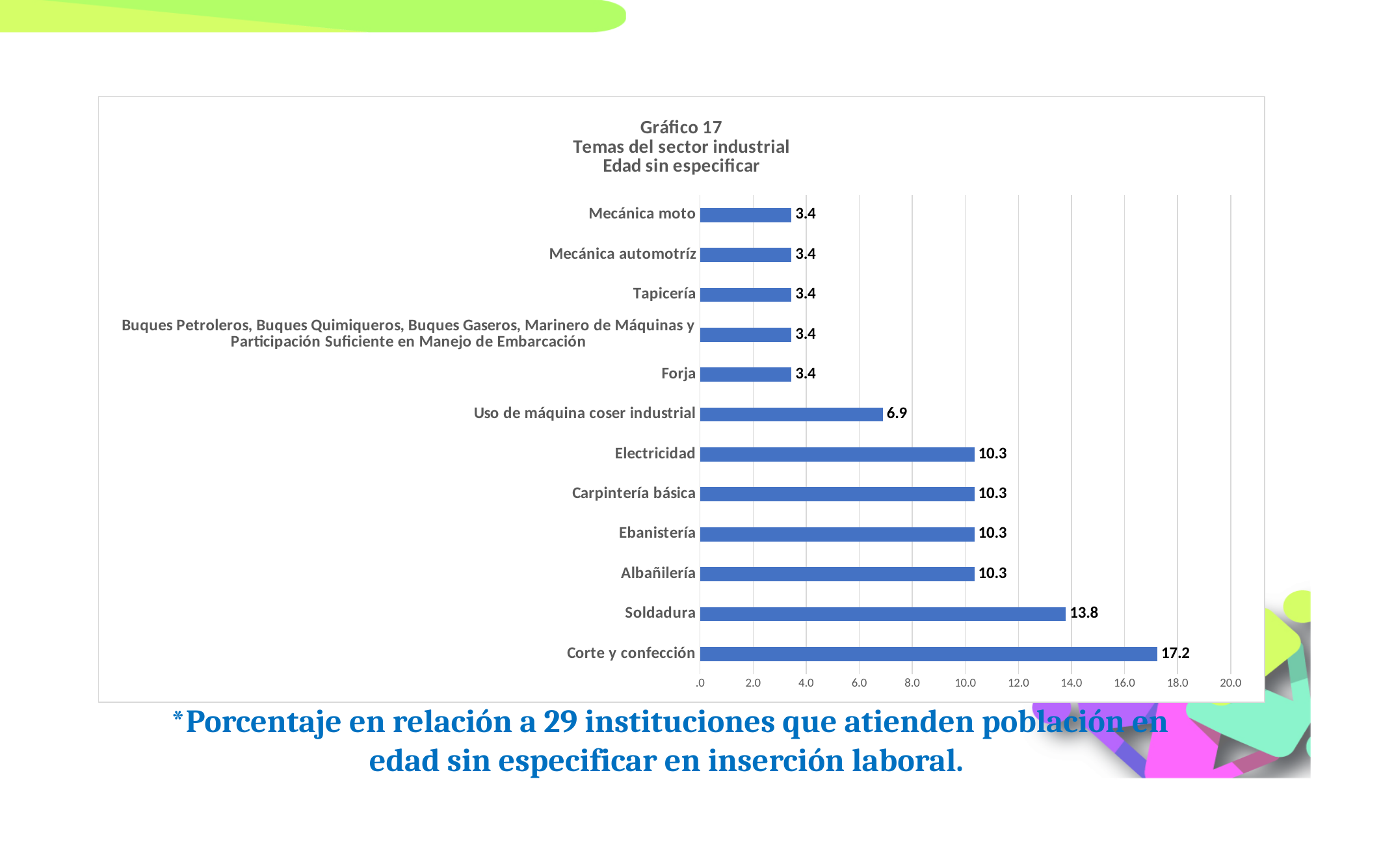
What kind of chart is shown on the slide? Bar chart What is the value for Forja? 3.4 What is the value for Soldadura? 13.8 Which is larger, the value for Soldadura or the value for Ebanistería? Soldadura What is the value for Uso de máquina coser industrial? 6.9 What is the difference between the values for Albañilería and Uso de máquina coser industrial? 3.4 What is the value for Corte y confección? 17.2 What is the difference between the values for Corte y confección and Soldadura? 3.4 What is the title of the chart? Gráfico 17 Temas del sector industrial Edad sin especificar What is the value for Electricidad? 10.3 Which category has the highest value? Corte y confección How many categories are shown in the chart? 12